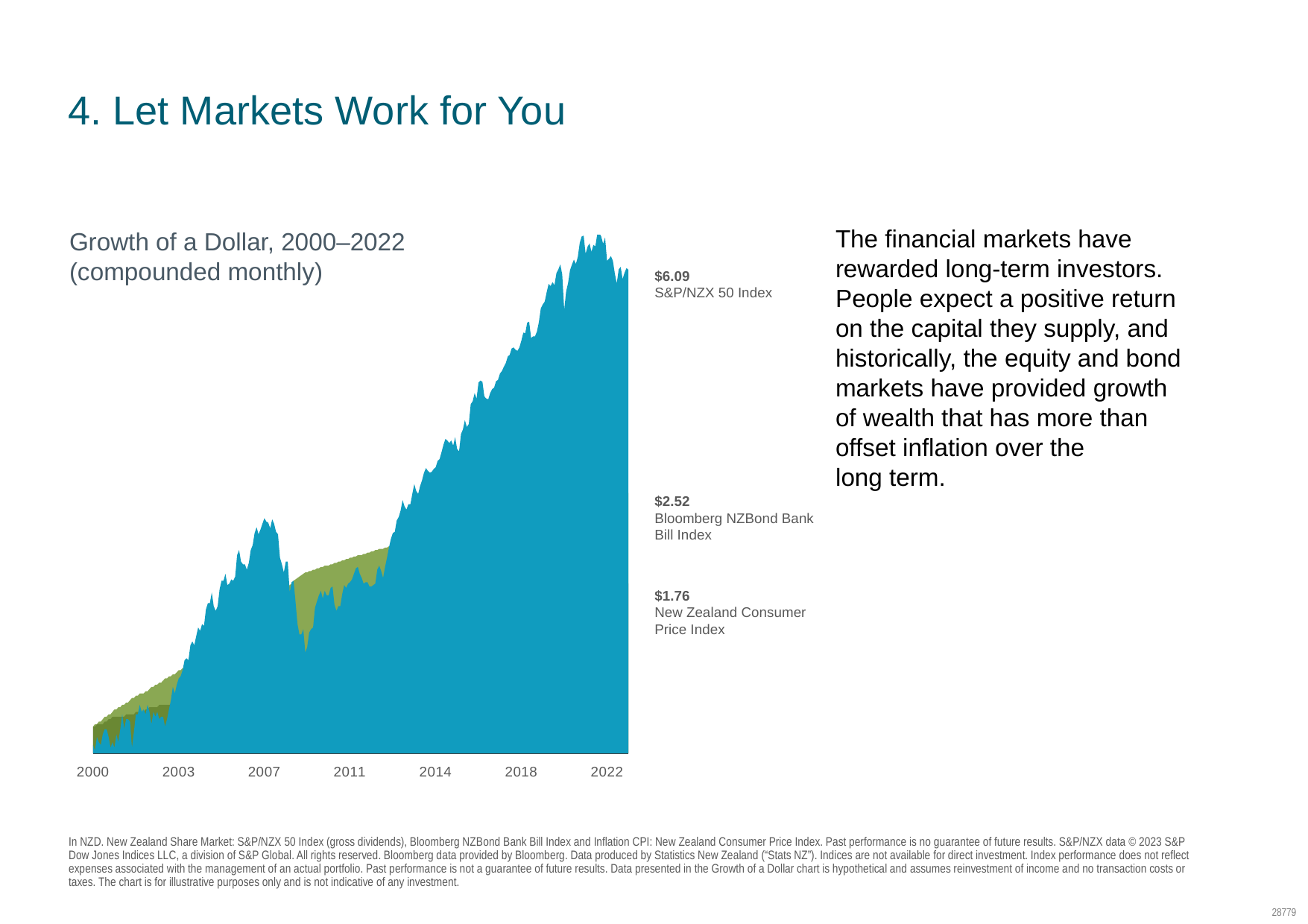
What kind of chart is the Growth of a Dollar chart? Area chart Which series has the lowest ending value in the Growth of a Dollar chart? New Zealand Consumer Price Index What is the ending value shown for the S&P/NZX 50 Index in the Growth of a Dollar chart? $6.09 Which has a larger ending value, the Bloomberg NZBond Bank Bill Index or the New Zealand Consumer Price Index? Bloomberg NZBond Bank Bill Index What is the ending value shown for the New Zealand Consumer Price Index? $1.76 How many series are plotted in the Growth of a Dollar chart? 3 Does the S&P/NZX 50 Index series generally rise or fall from 2000 to 2022? Rise What is the difference between the ending values of the S&P/NZX 50 Index and the Bloomberg NZBond Bank Bill Index? $3.57 Which series has the highest ending value in the Growth of a Dollar chart? S&P/NZX 50 Index What is the title of the chart on the slide? Growth of a Dollar, 2000–2022 (compounded monthly) What is the difference between the ending values of the Bloomberg NZBond Bank Bill Index and the New Zealand Consumer Price Index? $0.76 What is the ending value shown for the Bloomberg NZBond Bank Bill Index? $2.52